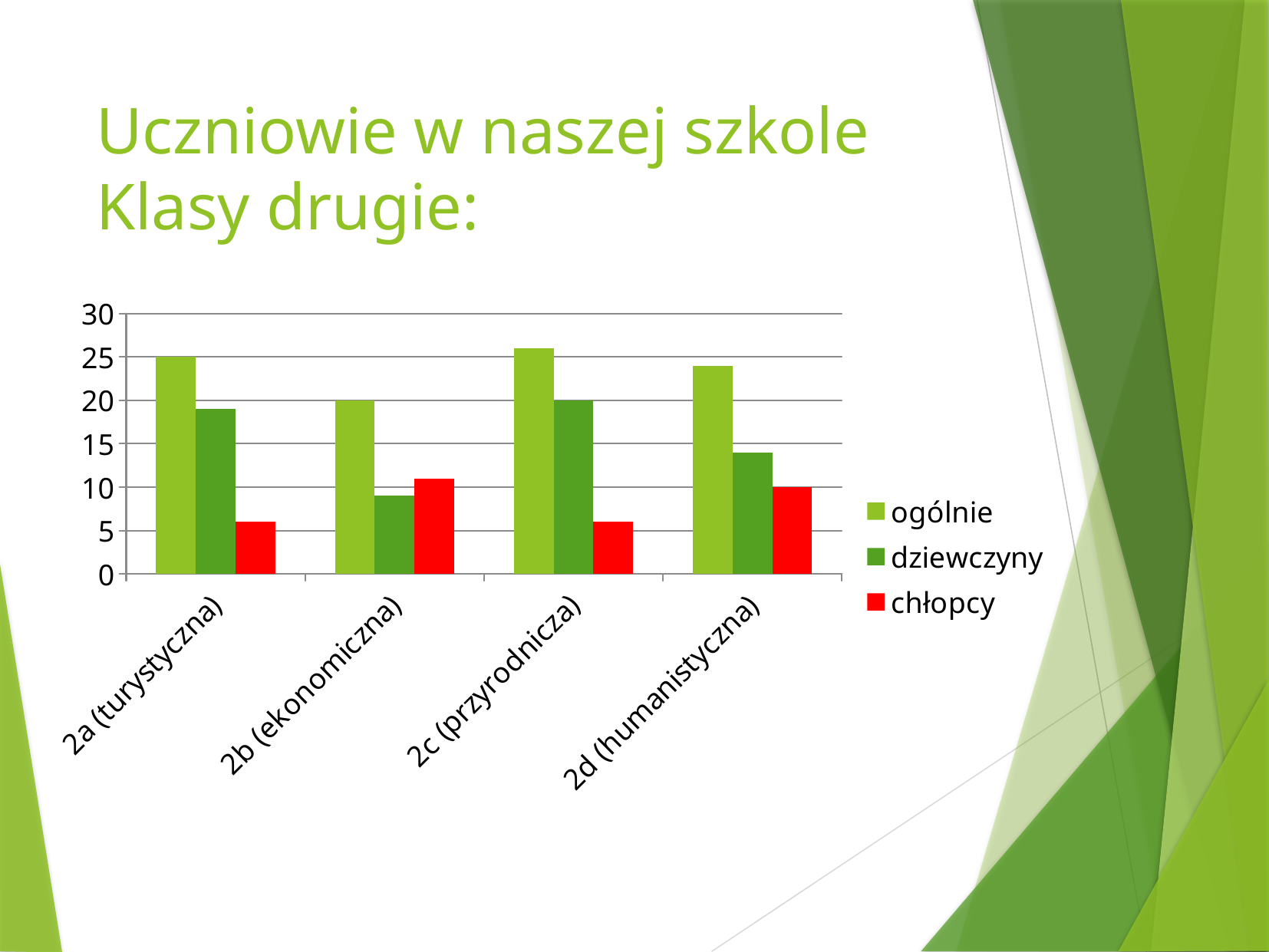
How many series does the legend list? 3 Which class has the lowest dziewczyny value? 2b (ekonomiczna) What is the value of dziewczyny for 2c (przyrodnicza)? 20 Which class has the highest ogólnie value? 2c (przyrodnicza) What kind of chart is shown on the slide? bar chart Which series is shown in red in the legend? chłopcy Which is larger for 2b (ekonomiczna): dziewczyny or chłopcy? chłopcy How many classes (categories) are shown on the x axis? 4 What is the value of ogólnie for 2b (ekonomiczna)? 20 Is the value of chłopcy for 2a (turystyczna) greater or less than 10? less What is the value of chłopcy for 2d (humanistyczna)? 10 Is the value of dziewczyny for 2d (humanistyczna) greater or less than 10? greater